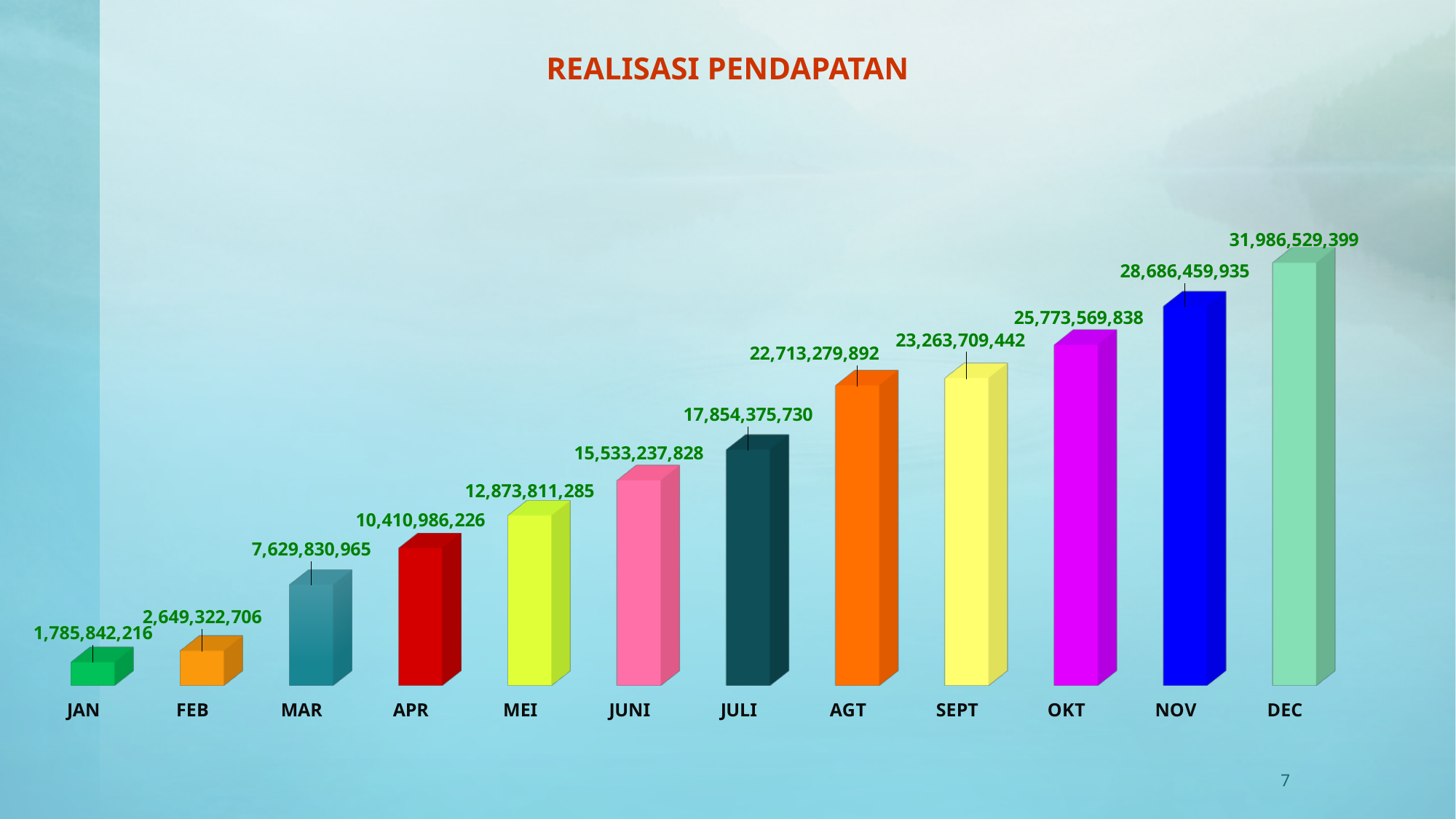
What is the title of the chart? REALISASI PENDAPATAN What is the value for JUNI? 15,533,237,828 What is the difference between the values for AGT and JULI? 4,858,904,162 What kind of chart is shown on the slide? Bar chart What is the difference between the values for DEC and NOV? 3,300,069,464 Which is larger, the value for APR or the value for MEI? MEI Which month has the highest value? DEC Do the values rise or fall from JAN to DEC? Rise What is the value for SEPT? 23,263,709,442 How many months are shown on the chart? 12 Which month has the lowest value? JAN What is the value for MAR? 7,629,830,965